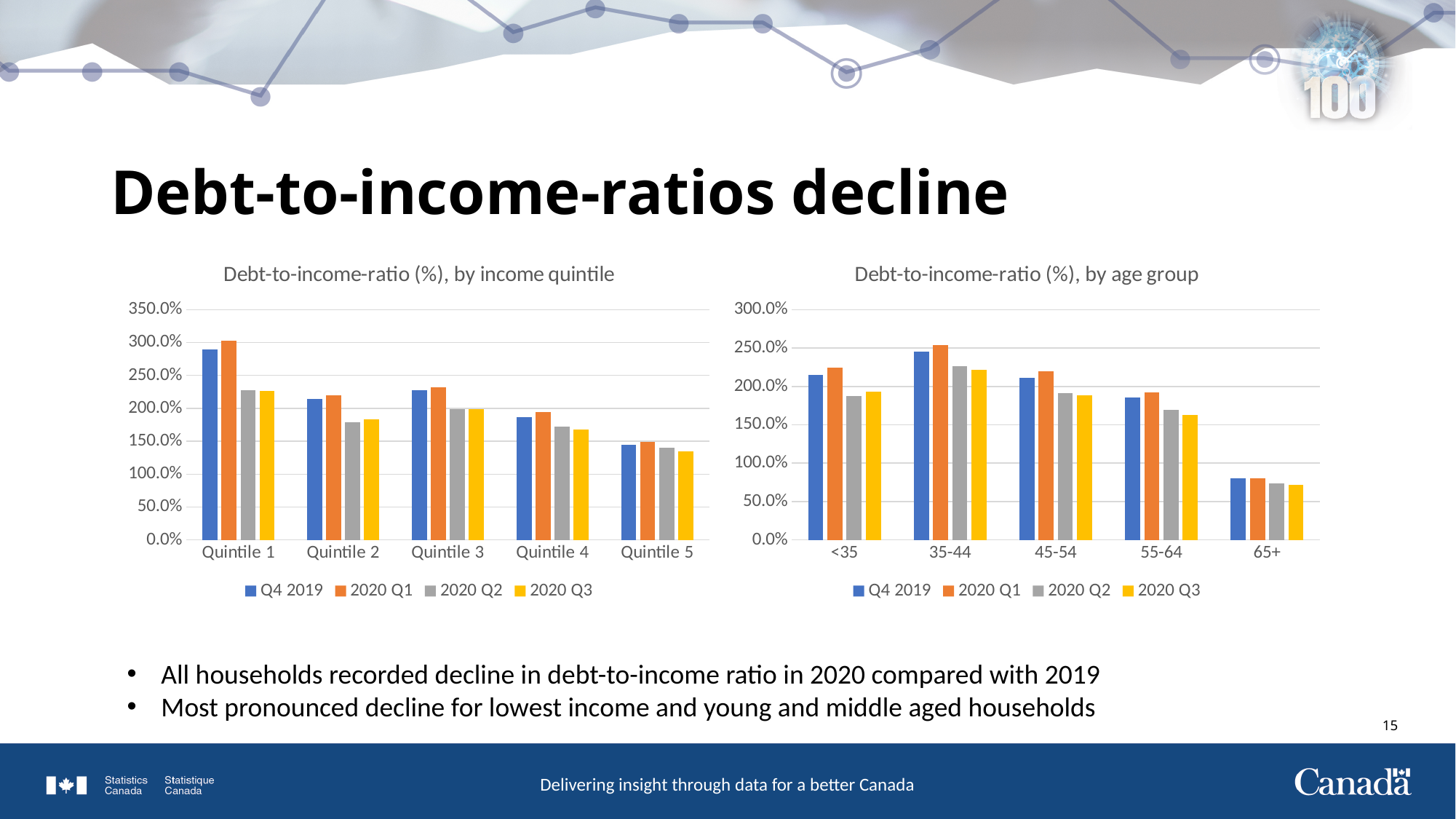
In the 'Debt-to-income-ratio (%), by age group' chart, which is larger for 2020 Q3: the value for <35 or the value for 65+? <35 How many series does the legend of the 'Debt-to-income-ratio (%), by age group' chart list? 4 In the 'Debt-to-income-ratio (%), by income quintile' chart, which quintile has the highest bar overall? Quintile 1 In the 'Debt-to-income-ratio (%), by age group' chart, is the Q4 2019 value for 45-54 greater or less than 200.0%? greater What kind of chart is the 'Debt-to-income-ratio (%), by income quintile' chart? bar chart In the 'Debt-to-income-ratio (%), by income quintile' chart, is the 2020 Q3 value for Quintile 5 greater or less than 150.0%? less In the 'Debt-to-income-ratio (%), by age group' chart, is the Q4 2019 value for 65+ greater or less than 100.0%? less In the 'Debt-to-income-ratio (%), by age group' chart, which age group has the lowest bars? 65+ How many age group categories are shown on the x axis of the 'Debt-to-income-ratio (%), by age group' chart? 5 In the 'Debt-to-income-ratio (%), by income quintile' chart, which quintile has the lowest values? Quintile 5 In the 'Debt-to-income-ratio (%), by age group' chart, which age group has the highest bars? 35-44